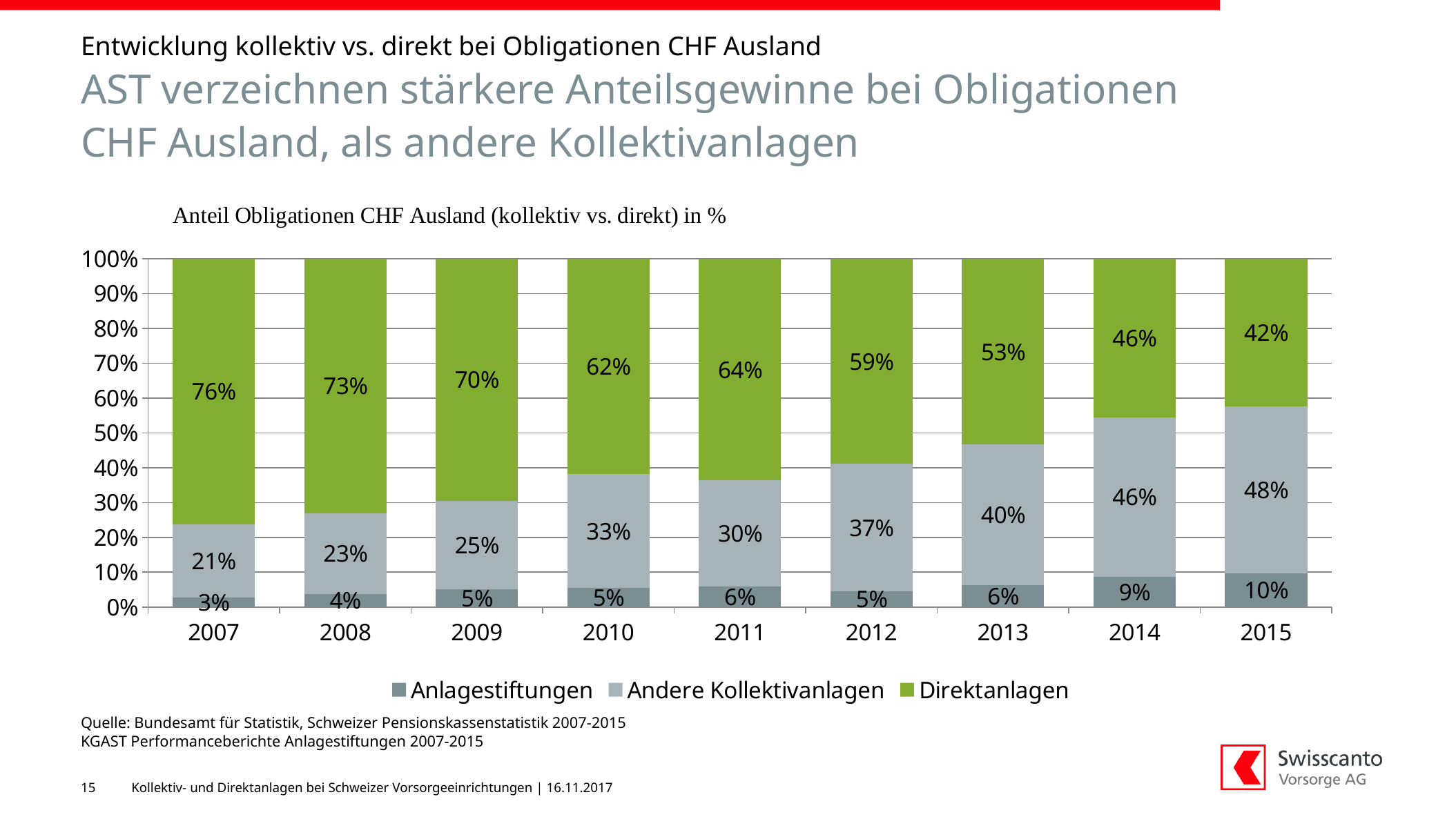
Does the Anlagestiftungen share generally rise or fall from 2007 to 2015? Rise What is the value for Direktanlagen in 2007? 76% In which year is the Direktanlagen share lowest? 2015 What is the difference between the Direktanlagen share in 2007 and in 2015? 34 percentage points What kind of chart is shown? Stacked bar chart How many years are shown on the x axis? 9 What is the value for Andere Kollektivanlagen in 2013? 40% How many series does the legend list? 3 What is the value for Anlagestiftungen in 2015? 10% Which is larger in 2014: the Andere Kollektivanlagen share or the Direktanlagen share? They are equal (46%) In which year is the Anlagestiftungen share highest? 2015 Which is larger in 2012: the Andere Kollektivanlagen share or the Direktanlagen share? Direktanlagen